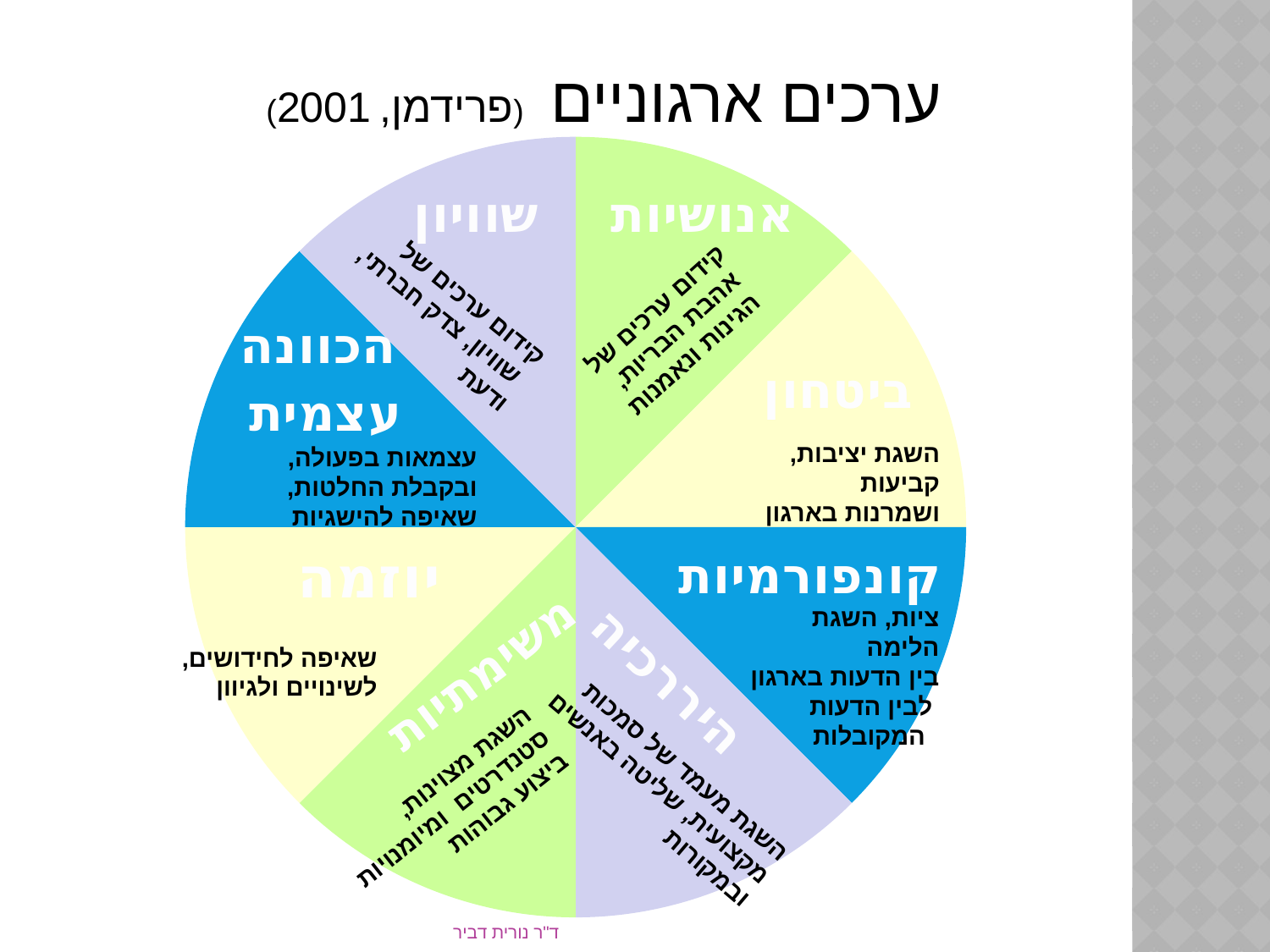
Which segment of the pie chart is labelled with the description 'השגת יציבות, קביעות ושמרנות בארגון'? ביטחון What colour is the segment labelled ביטחון? yellow How many segments does the pie chart have? 8 What is the title of the chart on the slide? ערכים ארגוניים (פרידמן, 2001) What kind of chart is shown on the slide? pie chart Which segment of the pie chart is labelled with the description 'שאיפה לחידושים, לשינויים ולגיוון'? יוזמה